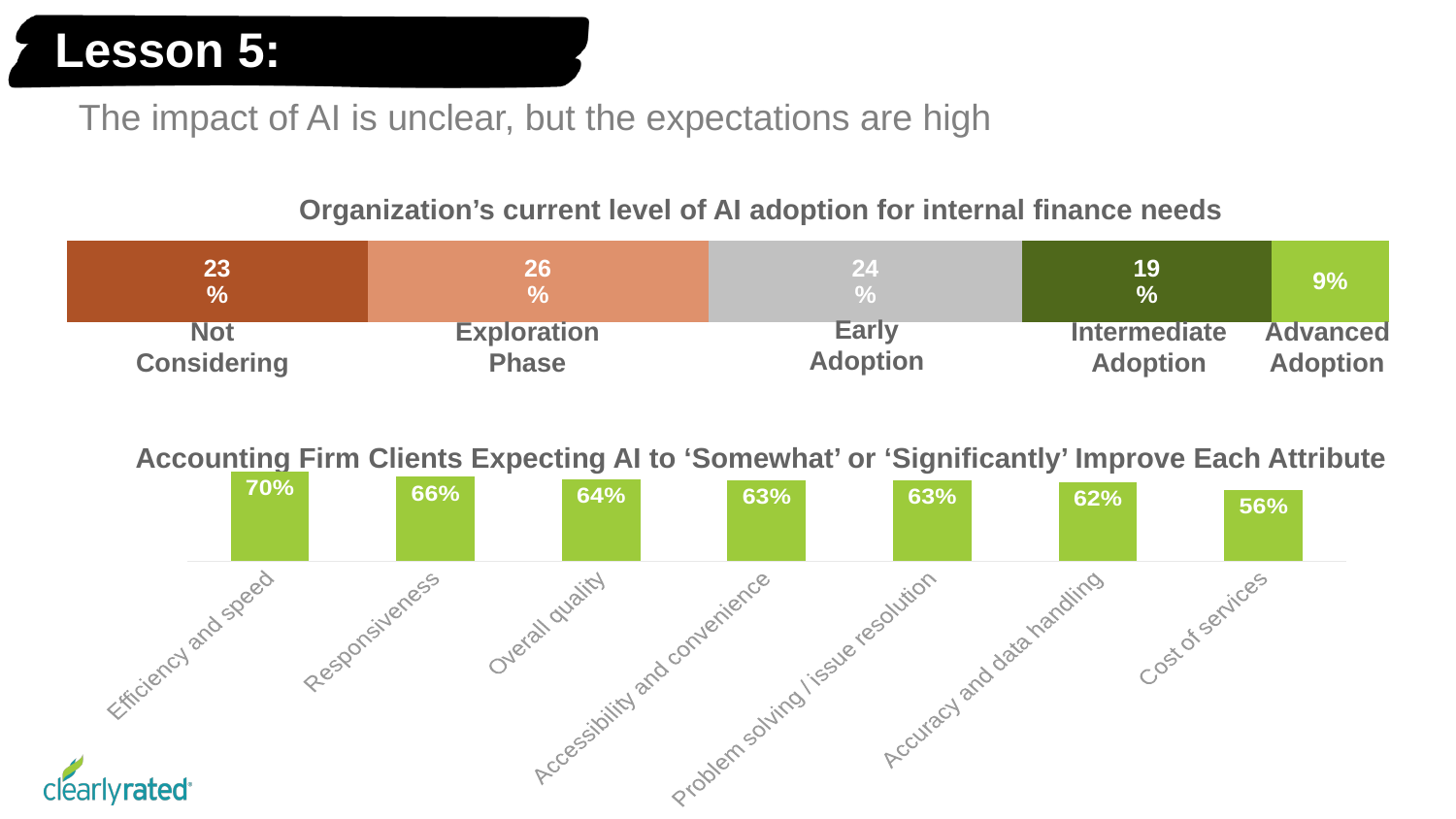
In the chart titled "Organization's current level of AI adoption for internal finance needs", which adoption level has the largest share? Exploration Phase In the chart titled "Organization's current level of AI adoption for internal finance needs", what is the difference between the Not Considering and Intermediate Adoption percentages? 4% In the chart titled "Organization's current level of AI adoption for internal finance needs", which adoption level has the smallest share? Advanced Adoption In the chart titled "Accounting Firm Clients Expecting AI to 'Somewhat' or 'Significantly' Improve Each Attribute", what is the difference between Efficiency and speed and Cost of services? 14% In the chart titled "Accounting Firm Clients Expecting AI to 'Somewhat' or 'Significantly' Improve Each Attribute", what kind of chart is used? Bar chart In the chart titled "Accounting Firm Clients Expecting AI to 'Somewhat' or 'Significantly' Improve Each Attribute", which attribute has the lowest value? Cost of services In the chart titled "Organization's current level of AI adoption for internal finance needs", what percentage are at Advanced Adoption? 9% In the chart titled "Organization's current level of AI adoption for internal finance needs", what percentage of organizations are in the Exploration Phase? 26% In the chart titled "Organization's current level of AI adoption for internal finance needs", how many adoption levels are shown? 5 In the chart titled "Accounting Firm Clients Expecting AI to 'Somewhat' or 'Significantly' Improve Each Attribute", what is the value for Accuracy and data handling? 62% In the chart titled "Accounting Firm Clients Expecting AI to 'Somewhat' or 'Significantly' Improve Each Attribute", what is the value for Responsiveness? 66% In the chart titled "Accounting Firm Clients Expecting AI to 'Somewhat' or 'Significantly' Improve Each Attribute", which attribute has the highest value? Efficiency and speed